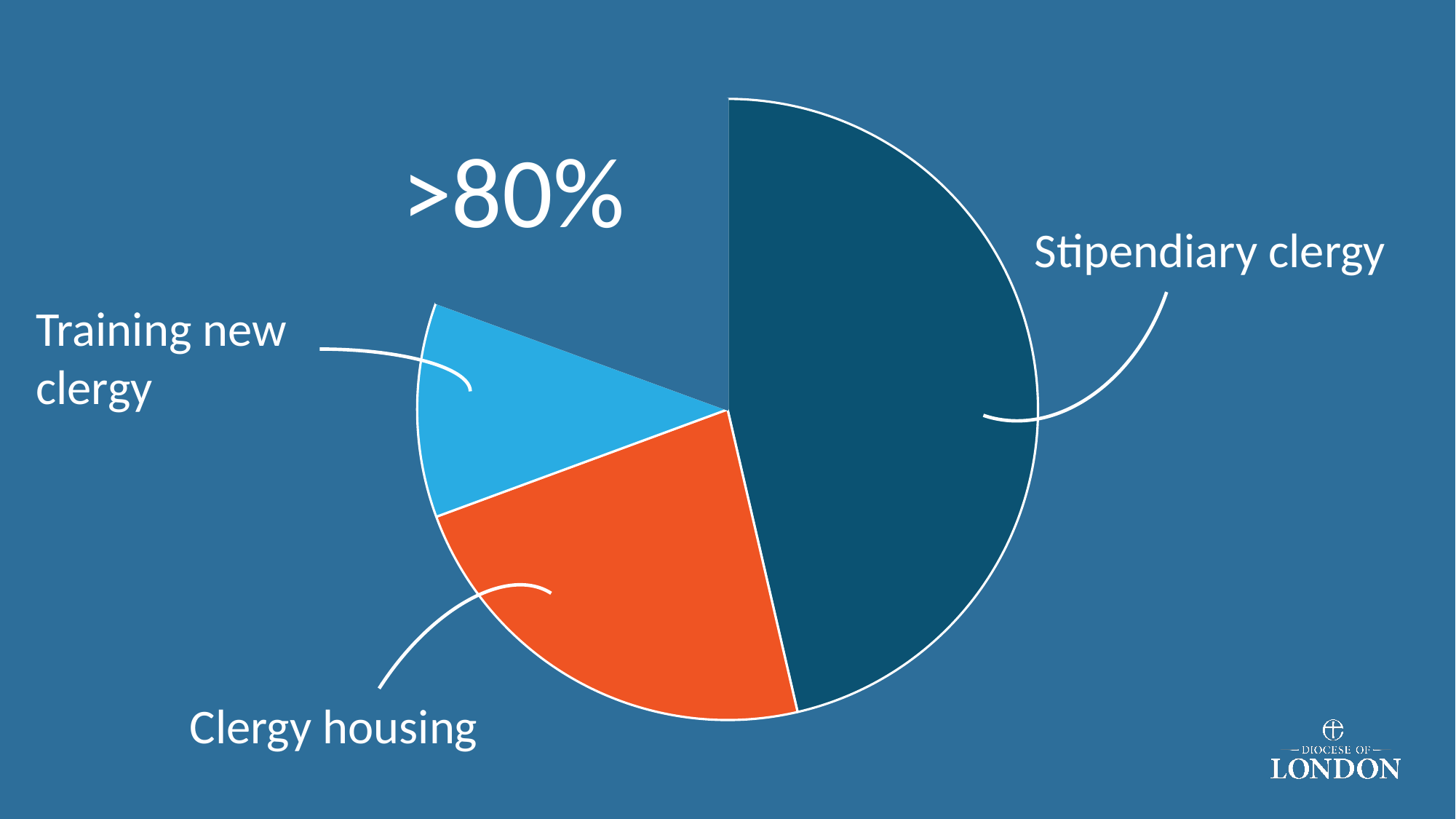
Which category has the smallest slice of the pie chart? Training new clergy Which category has the largest slice of the pie chart? Stipendiary clergy What colour is the Clergy housing slice? orange What percentage figure is printed on the slide next to the pie chart? >80% What kind of chart is shown on the slide? pie chart Which slice is larger, Stipendiary clergy or Clergy housing? Stipendiary clergy How many slices does the pie chart have? 3 Which slice is larger, Clergy housing or Training new clergy? Clergy housing